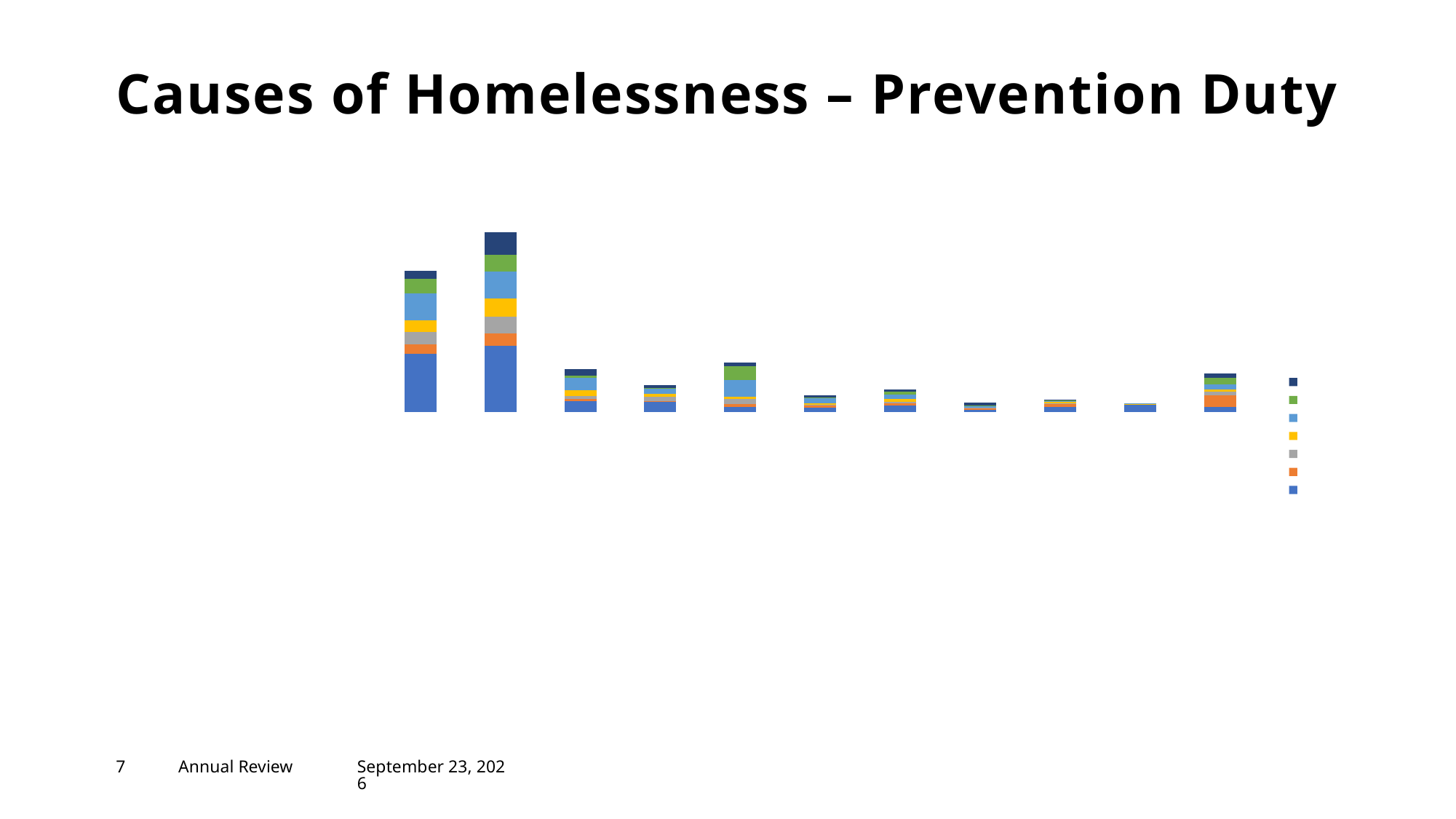
Which is taller, the first bar from the left or the rightmost bar? The first bar What kind of chart is shown on the slide? Stacked bar chart Which is taller, the first bar from the left or the second bar from the left? The second bar Which is taller, the second bar from the left or the fifth bar from the left? The second bar How many series does the legend list? 7 Which bar is the tallest in the chart, counting from the left? The second bar What is the title of the slide containing the chart? Causes of Homelessness – Prevention Duty What colour is the bottom segment of each stacked bar? Blue How many bars are plotted in the chart? 11